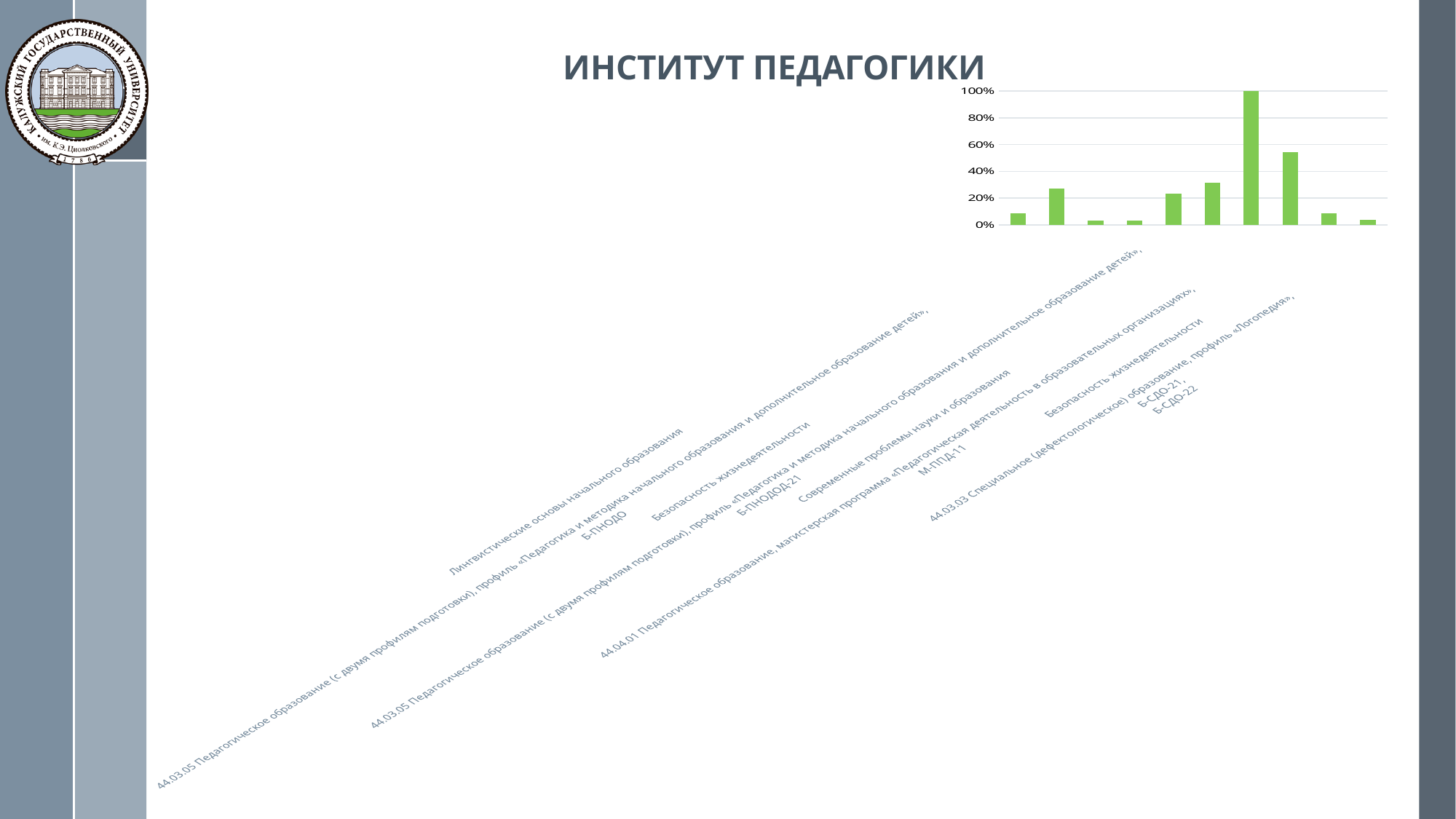
Which is larger: the sixth bar from the left or the first bar from the left? the sixth bar How many bars does the chart contain? 10 Is the value of the third bar from the left greater or less than 20%? less Which is larger: the eighth bar from the left or the second bar from the left? the eighth bar Is the value of the eighth bar from the left greater or less than 40%? greater Is the value of the eighth bar from the left greater or less than 60%? less What value does the tallest bar reach on the vertical axis? 100% What kind of chart is shown on the slide? bar chart What colour are the bars in the chart? green Which bar is the tallest in the chart? the seventh bar from the left How many bars in the chart are below 20%? 5